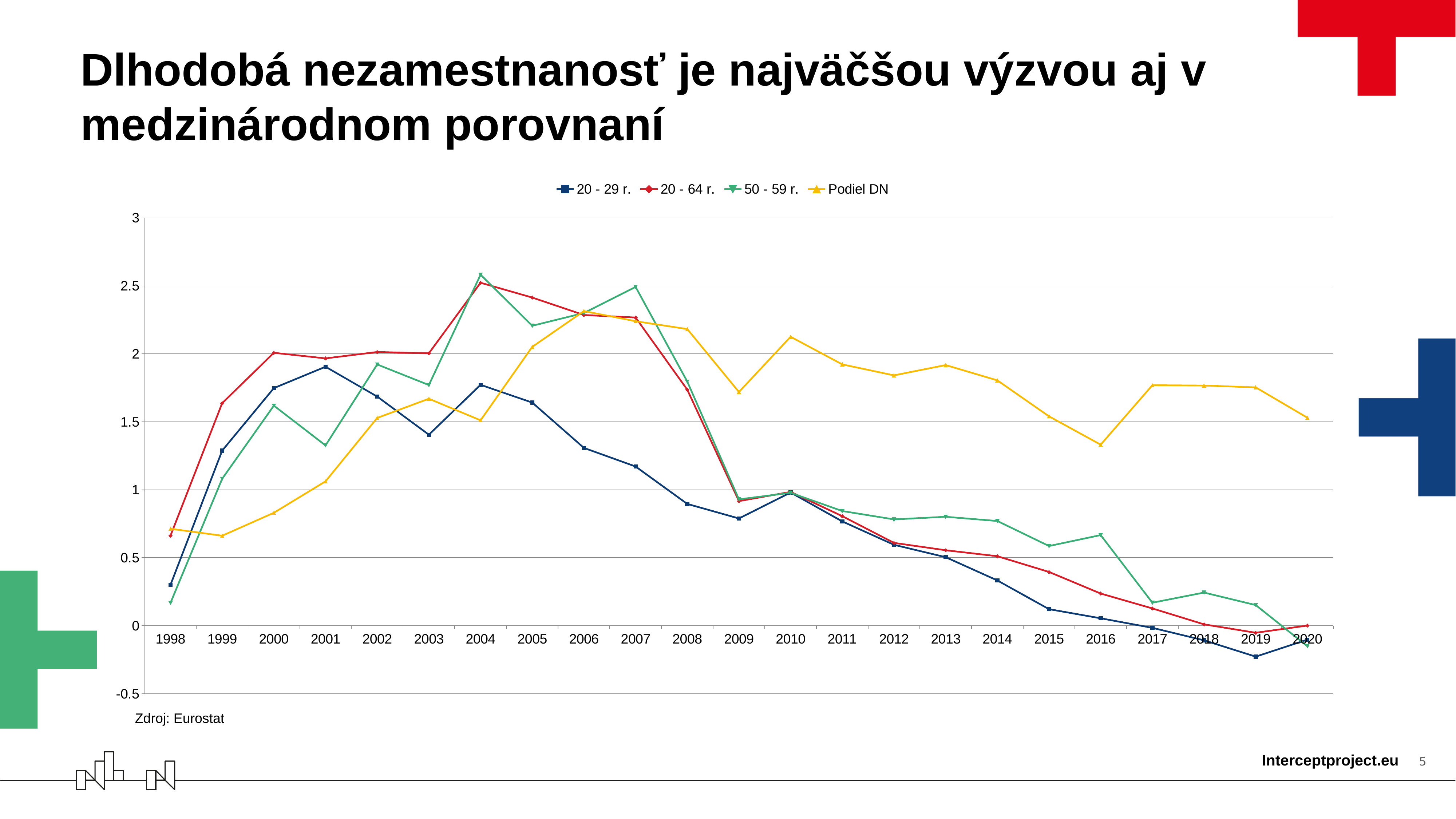
How many series does the legend list? 4 How many years are shown on the x axis? 23 Is the value for 50 - 59 r. in 2004 greater or less than 2? greater Which series has the lowest value in 2019? 20 - 29 r. Which series has the highest value in 2020? Podiel DN Is the value for 20 - 29 r. in 2019 greater or less than 0? less Does the 20 - 29 r. series rise or fall from 2010 to 2019? fall What kind of chart is shown on the slide? line chart Is the value for Podiel DN in 2016 greater or less than 1.5? less In 2001, which is larger: the value for 20 - 64 r. or for 50 - 59 r.? 20 - 64 r. In which year does the 20 - 29 r. series reach its highest value? 2001